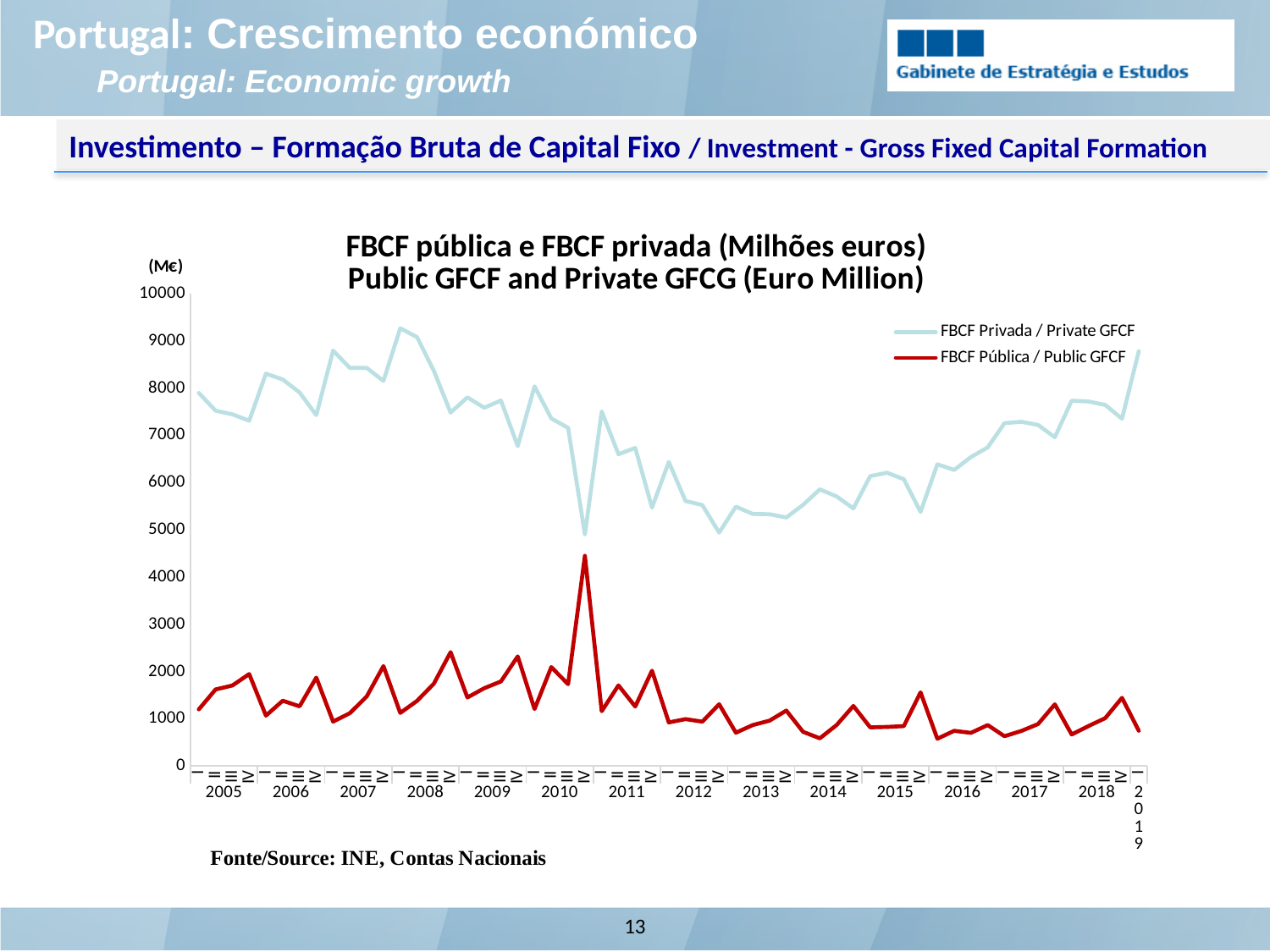
Does the Private GFCF series generally rise or fall between 2008 and 2012? fall Is the value of Private GFCF in the first quarter of 2005 greater or less than 7000? greater How many series does the chart legend list? 2 Is the value of Private GFCF in the third quarter of 2012 greater or less than 6000? less Which series is drawn in dark red? FBCF Pública / Public GFCF In which year does the Private GFCF series reach its highest peak? 2008 What kind of chart is shown on the slide? line chart In which year does the Public GFCF series reach its highest peak? 2010 What is the unit shown at the top of the vertical axis? (M€) Which series has higher values throughout the chart, Private GFCF or Public GFCF? FBCF Privada / Private GFCF Is the highest value of the Public GFCF series greater or less than 4000? greater How many years are labelled on the horizontal axis? 15